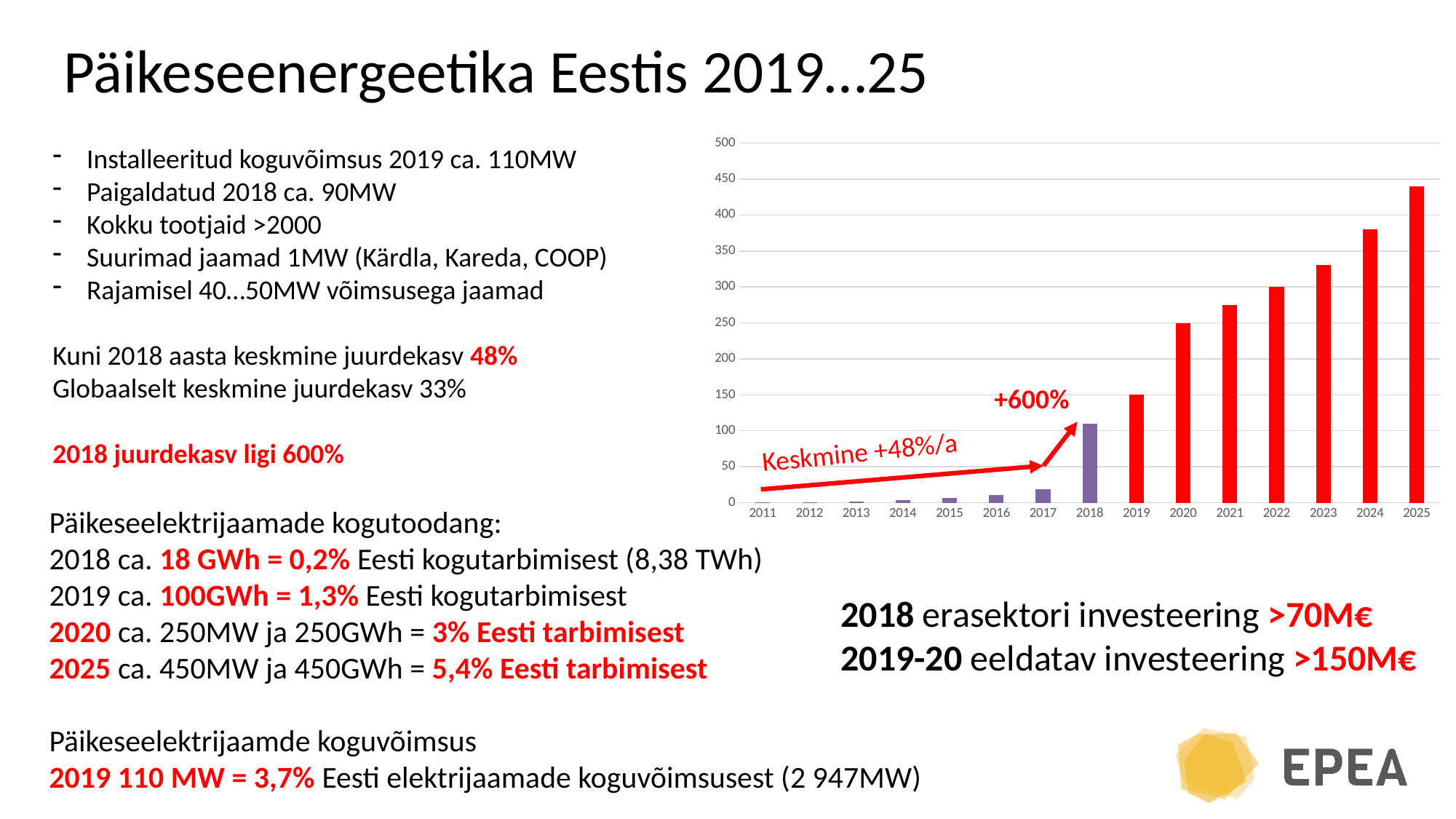
Is the value for 2018 greater or less than 150? less Do the bar values rise or fall from 2011 to 2025? rise Is the value for 2017 greater or less than 50? less Which is larger, the value for 2019 or the value for 2018? 2019 Which is larger, the value for 2023 or the value for 2021? 2023 Which year has the highest bar in the chart? 2025 Is the value for 2024 greater or less than 400? less What average annual growth rate is written along the arrow in the chart? Keskmine +48%/a What kind of chart is shown on the slide? bar chart What growth percentage is annotated next to the 2018 bar in the chart? +600% How many years are shown on the x axis of the chart? 15